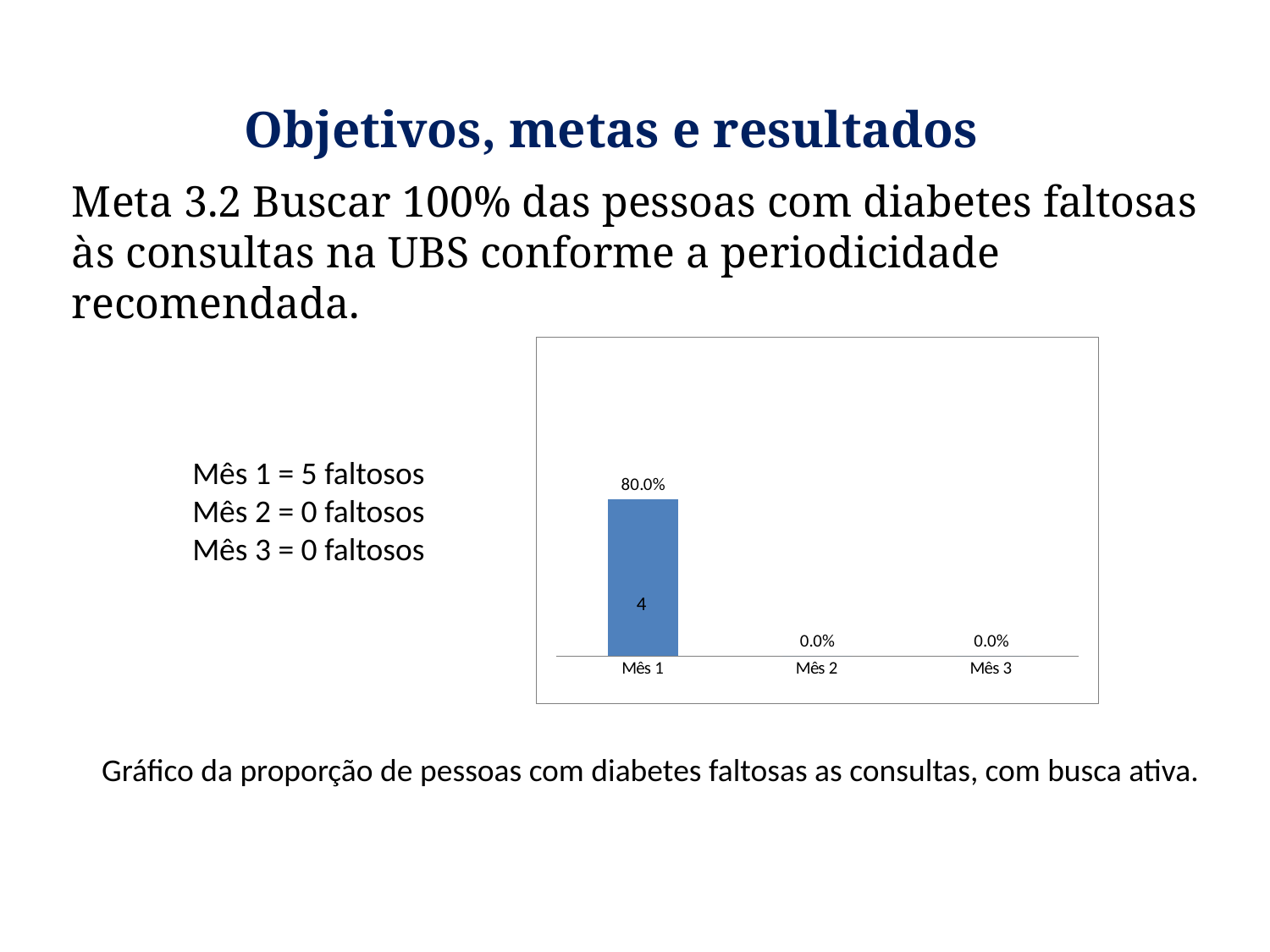
What is the value shown for Mês 3? 0.0% What number is printed inside the bar for Mês 1? 4 Do the values rise or fall from Mês 1 to Mês 3? fall What colour is the bar for Mês 1? blue What is the difference between the values for Mês 1 and Mês 2? 80.0% How many categories are shown on the x axis of the chart? 3 According to the text beside the chart, how many 'faltosos' were there in Mês 1? 5 Which is larger, the value for Mês 1 or the value for Mês 3? Mês 1 What is the value shown for Mês 1? 80.0% What is the value shown for Mês 2? 0.0% What kind of chart is shown on the slide? bar chart Which month has the highest value in the chart? Mês 1